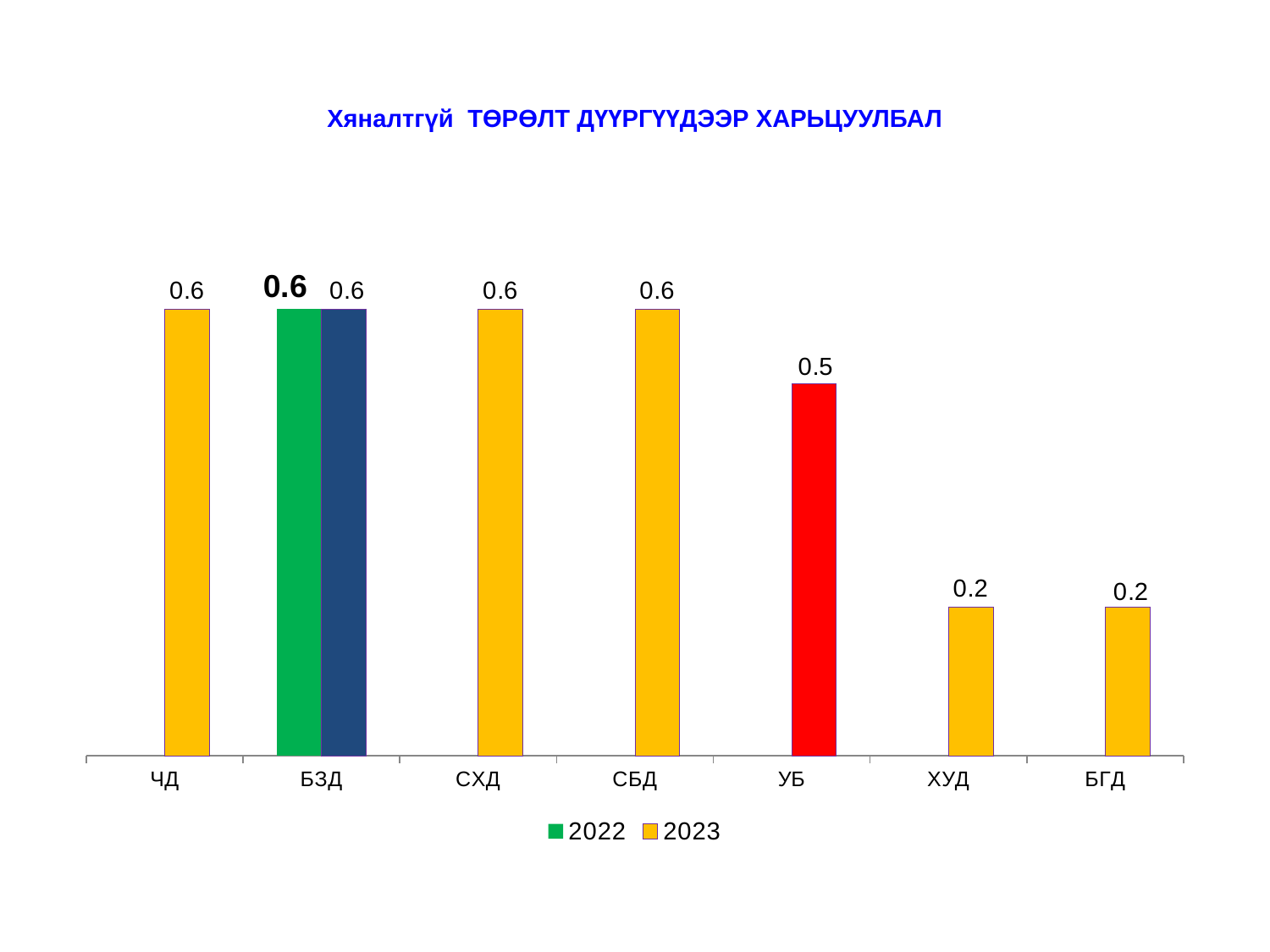
What is the difference between the values for ЧД and УБ? 0.1 What is the 2023 value for БГД? 0.2 How many series does the legend list? 2 How many districts (categories) are shown on the x axis? 7 What is the value shown for УБ? 0.5 What kind of chart is shown on the slide? Bar chart What is the 2022 value for БЗД? 0.6 Which has the larger value, УБ or БГД? УБ What is the difference between the 2023 values for СБД and ХУД? 0.4 Which has the larger value, СХД or УБ? СХД What is the 2023 value for ЧД? 0.6 What is the 2023 value for ХУД? 0.2